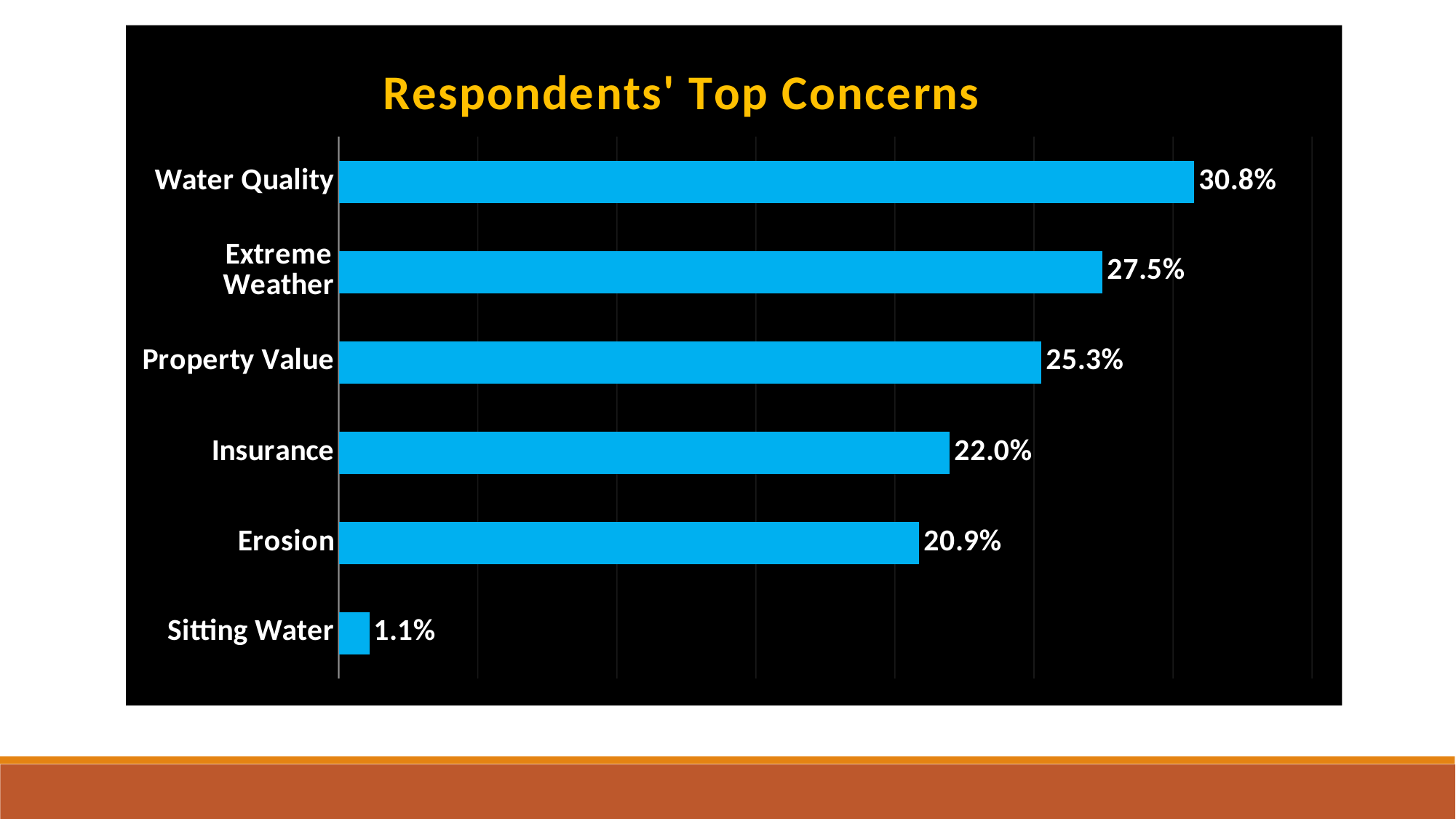
Which concern has the highest value? Water Quality What is the value for Extreme Weather? 27.5% What is the value for Sitting Water? 1.1% Which concern has the lowest value? Sitting Water What is the difference between the values for Property Value and Erosion? 4.4% What is the value for Water Quality? 30.8% What is the value for Insurance? 22.0% What kind of chart is shown on the slide? Bar chart What is the difference between the values for Water Quality and Extreme Weather? 3.3% Which is larger, the value for Insurance or the value for Erosion? Insurance How many concerns are shown in the chart? 6 What is the title of the chart? Respondents' Top Concerns